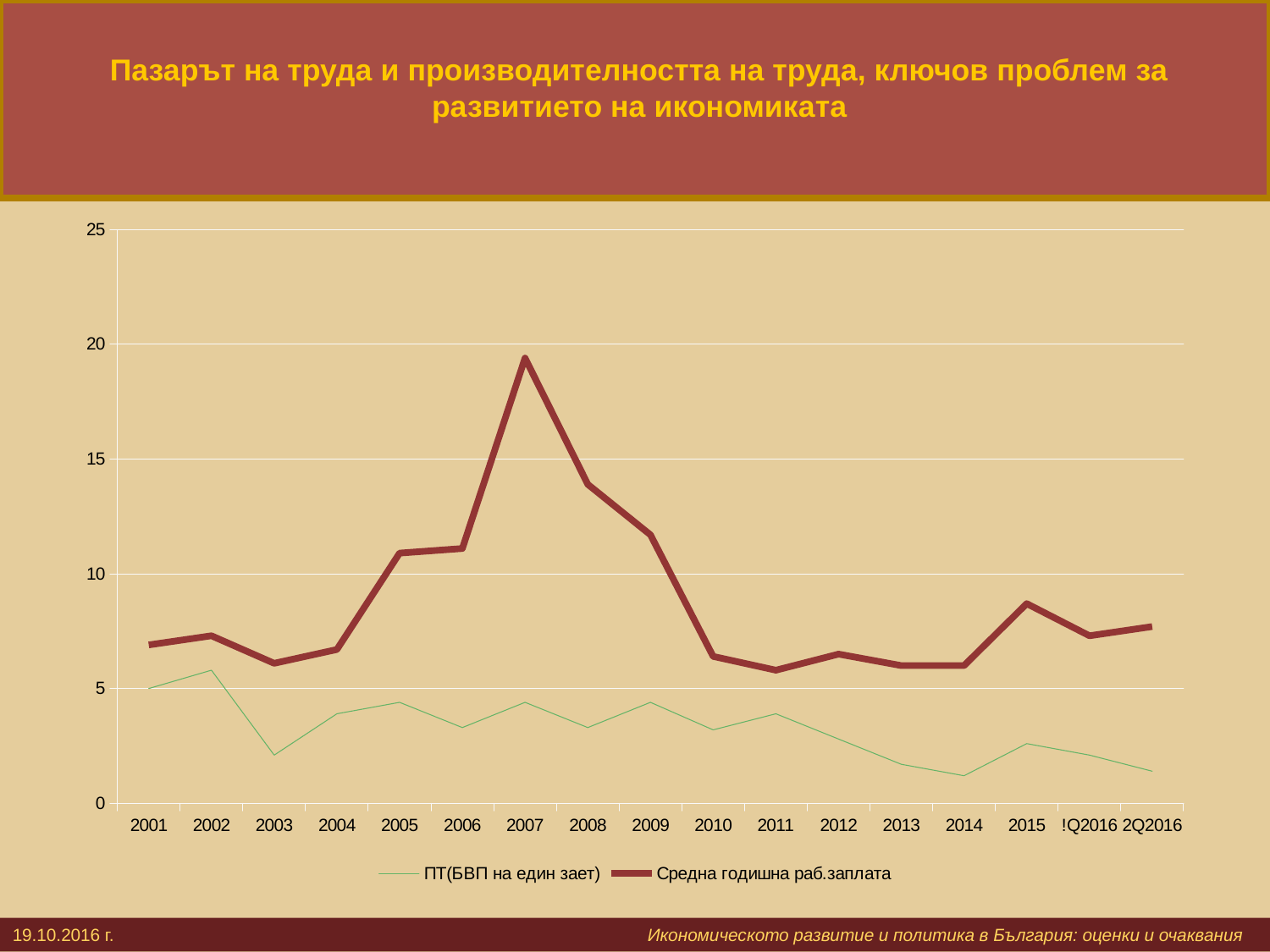
Is the value of 'Средна годишна раб.заплата' in 2007 greater or less than 15? greater Which series is drawn with the thick dark red line? Средна годишна раб.заплата In which year does the series 'Средна годишна раб.заплата' reach its highest value? 2007 Is the value of 'Средна годишна раб.заплата' in 2010 greater or less than 10? less What kind of chart is shown on the slide? line chart How many points are plotted along the x axis? 17 Is the value of 'Средна годишна раб.заплата' in 2005 greater or less than 10? greater Does the series 'Средна годишна раб.заплата' rise or fall from 2007 to 2010? fall Which series has the larger value in 2007, 'ПТ(БВП на един зает)' or 'Средна годишна раб.заплата'? Средна годишна раб.заплата How many series does the legend list? 2 In which year does the series 'ПТ(БВП на един зает)' reach its highest value? 2002